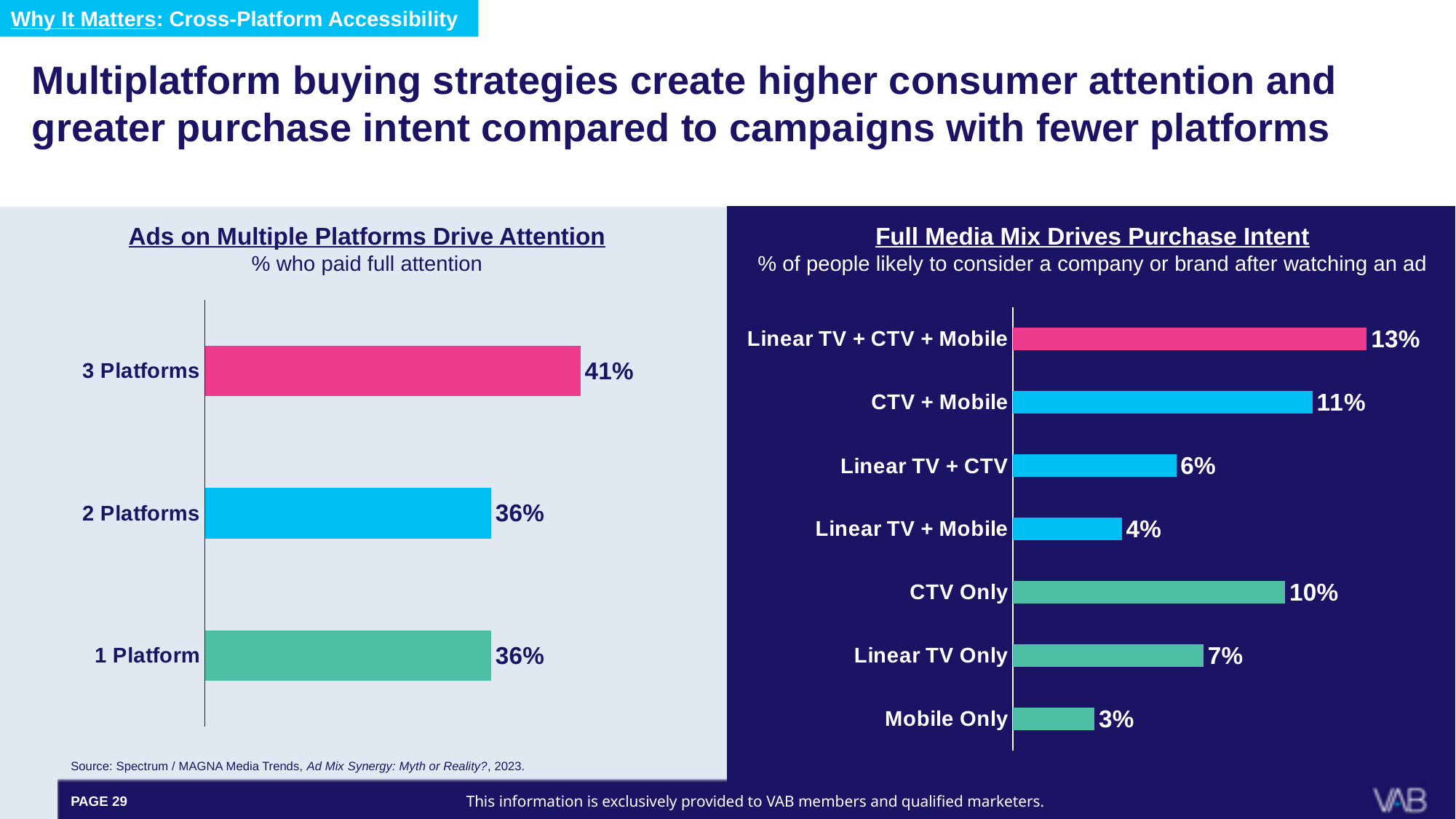
In the 'Full Media Mix Drives Purchase Intent' chart, which is larger: CTV + Mobile or Linear TV + CTV? CTV + Mobile In the 'Full Media Mix Drives Purchase Intent' chart, what is the value for CTV Only? 10% In the 'Ads on Multiple Platforms Drive Attention' chart, what percentage paid full attention for 3 Platforms? 41% In the 'Full Media Mix Drives Purchase Intent' chart, which category has the lowest value? Mobile Only In the 'Ads on Multiple Platforms Drive Attention' chart, what is the difference between 3 Platforms and 2 Platforms? 5 percentage points In the 'Ads on Multiple Platforms Drive Attention' chart, which category has the highest value? 3 Platforms In the 'Ads on Multiple Platforms Drive Attention' chart, what is the value for 1 Platform? 36% In the 'Full Media Mix Drives Purchase Intent' chart, how many categories are shown? 7 In the 'Ads on Multiple Platforms Drive Attention' chart, how many categories are shown? 3 In the 'Full Media Mix Drives Purchase Intent' chart, what is the difference between Linear TV Only and Mobile Only? 4 percentage points In the 'Full Media Mix Drives Purchase Intent' chart, what is the value for Linear TV + CTV + Mobile? 13% What type of chart is the 'Full Media Mix Drives Purchase Intent' chart? Bar chart